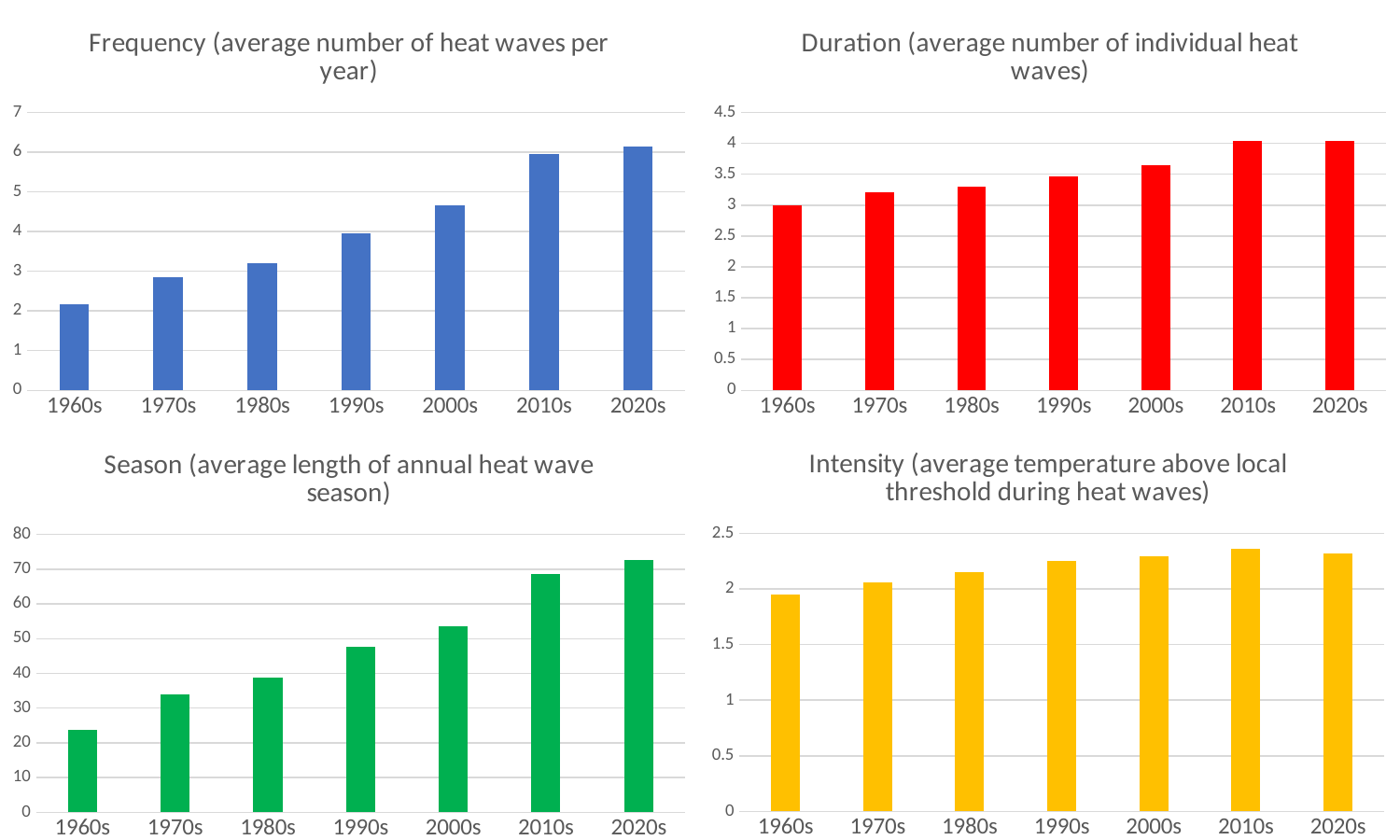
In the Duration chart, is the value for the 2000s greater or less than 3.5? greater In the Intensity chart, is the value for the 1960s greater or less than 2? less In the Season chart, which is larger, the value for the 1980s or the value for the 2000s? 2000s In the Intensity chart, which decade has the lowest value? 1960s In the Frequency chart, is the value for the 2000s greater or less than 4? greater In the Season chart, which decade has the highest value? 2020s In the Frequency chart, which decade has the lowest value? 1960s What kind of chart is the Duration chart? bar chart How many decades are shown on the x axis of the Season chart? 7